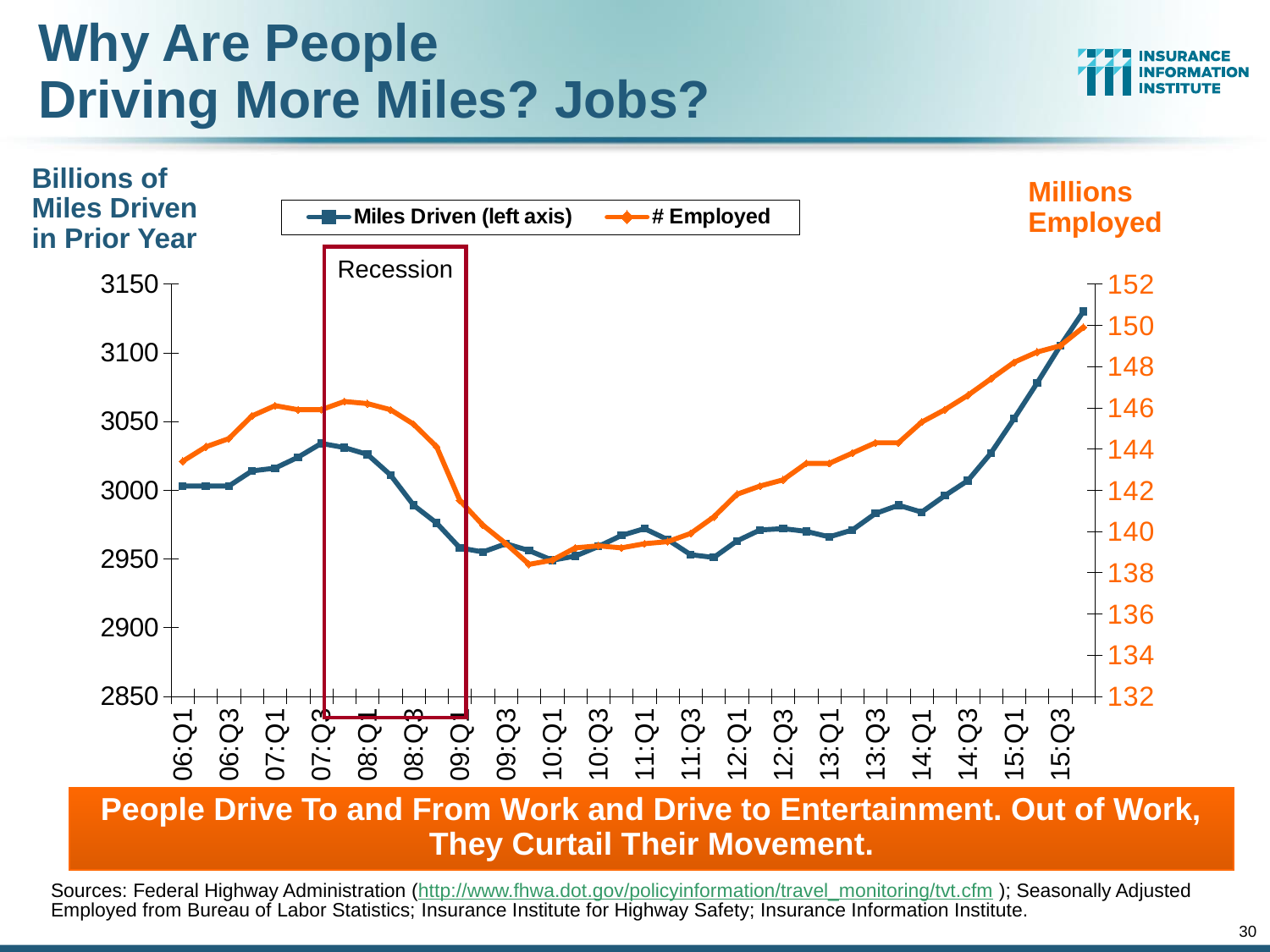
What kind of chart is shown on the slide? line chart How many series does the chart legend list? 2 Is the # Employed value at 15:Q3 greater or less than 148? greater Is the # Employed value at 09:Q3 greater or less than 140? less Which series is plotted on the left axis according to the legend? Miles Driven Which is higher for Miles Driven: the value at 07:Q3 or the value at 09:Q1? 07:Q3 Is the Miles Driven value at 07:Q3 greater or less than 3000? greater What label is shown inside the red box on the chart? Recession Does the # Employed series rise or fall between 07:Q3 and 09:Q3? fall Does the Miles Driven series rise or fall between 13:Q3 and 15:Q3? rise